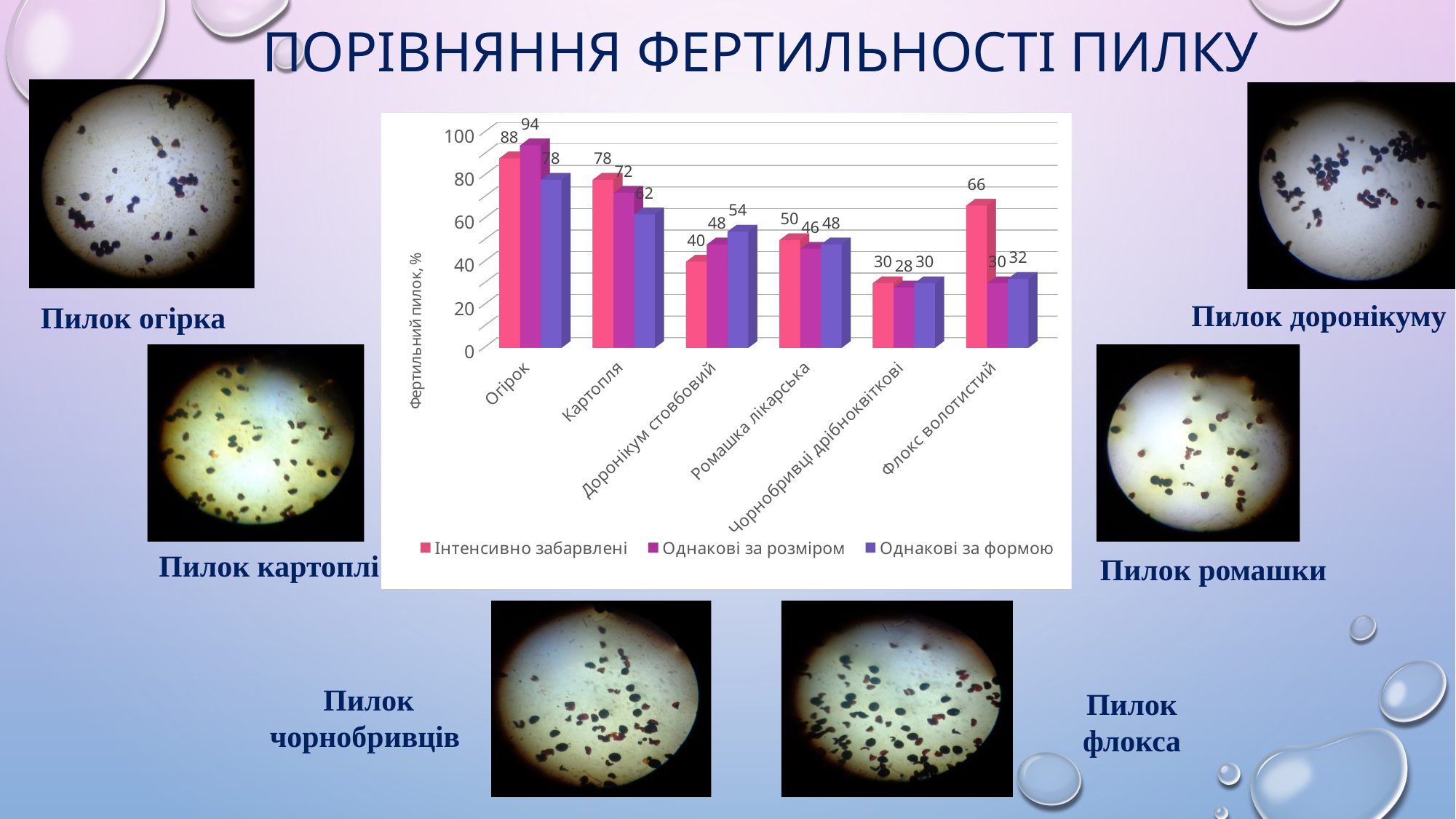
Which category has the highest value in the series Однакові за розміром? Огірок How many series does the legend list? 3 What is the value for Картопля in the series Однакові за формою? 62 Which category has the lowest value in the series Інтенсивно забарвлені? Чорнобривці дрібноквіткові What kind of chart is shown on the slide? Bar chart What is the value for Флокс волотистий in the series Інтенсивно забарвлені? 66 Which is larger for Доронікум стовбовий: the Інтенсивно забарвлені value or the Однакові за формою value? Однакові за формою What is the value for Огірок in the series Інтенсивно забарвлені? 88 How many categories are shown on the x axis? 6 What is the label of the vertical axis? Фертильний пилок, % What is the value for Доронікум стовбовий in the series Однакові за розміром? 48 What is the difference between the Інтенсивно забарвлені value and the Однакові за розміром value for Флокс волотистий? 36